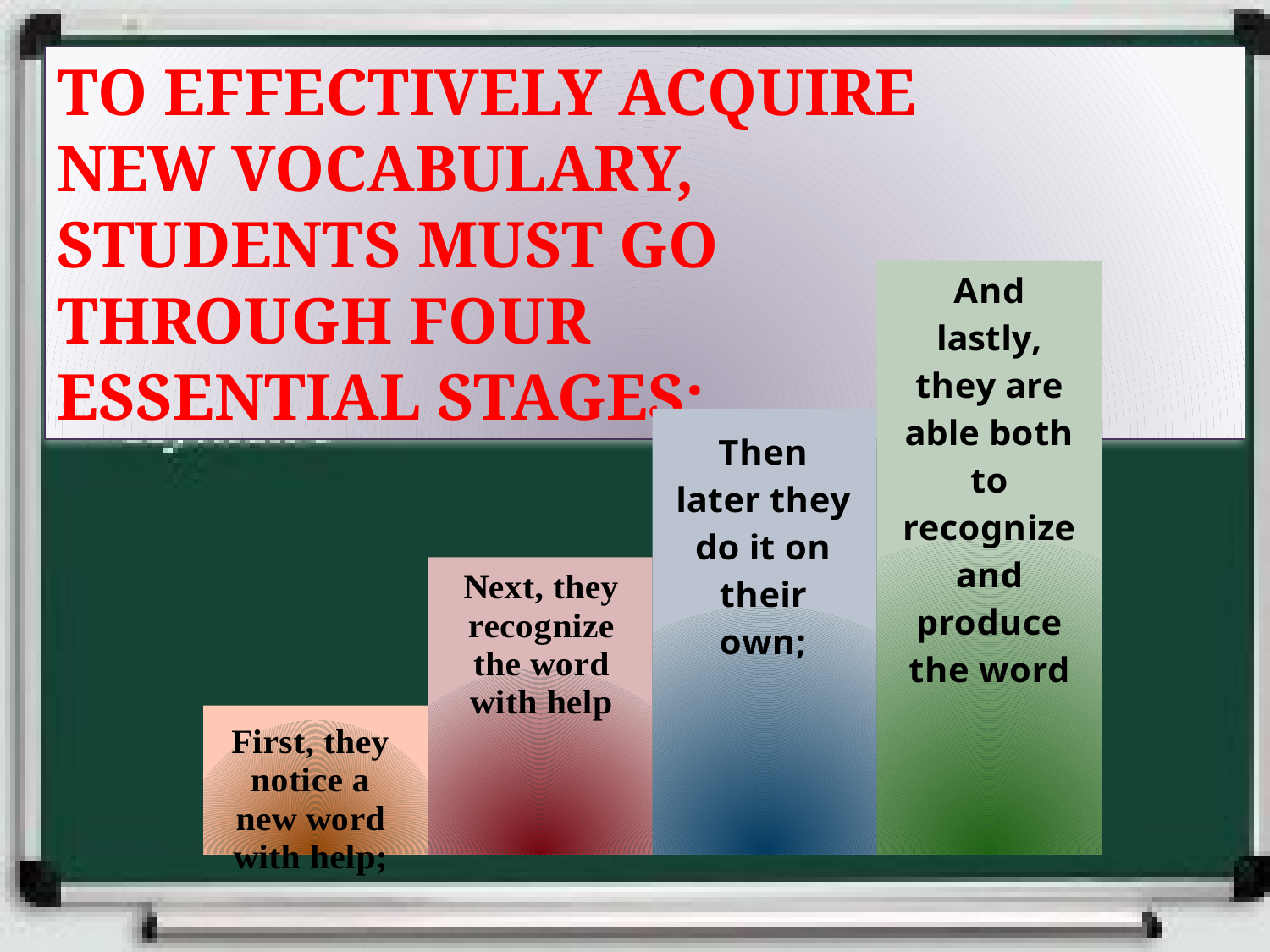
Which stage is shown with the tallest bar? And lastly, they are able both to recognize and produce the word What colour is the tallest bar in the diagram? green Which stage is shown with the shortest bar? First, they notice a new word with help According to the slide title, how many essential stages must students go through to acquire new vocabulary? four What is the text of the third stage in the diagram? Then later they do it on their own; Is the bar for 'Next, they recognize the word with help' taller or shorter than the bar for 'Then later they do it on their own'? shorter What is the text of the first (leftmost) stage in the diagram? First, they notice a new word with help; Do the bars rise or fall from left to right across the slide? rise How many stages (bars) are shown in the diagram on the slide? 4